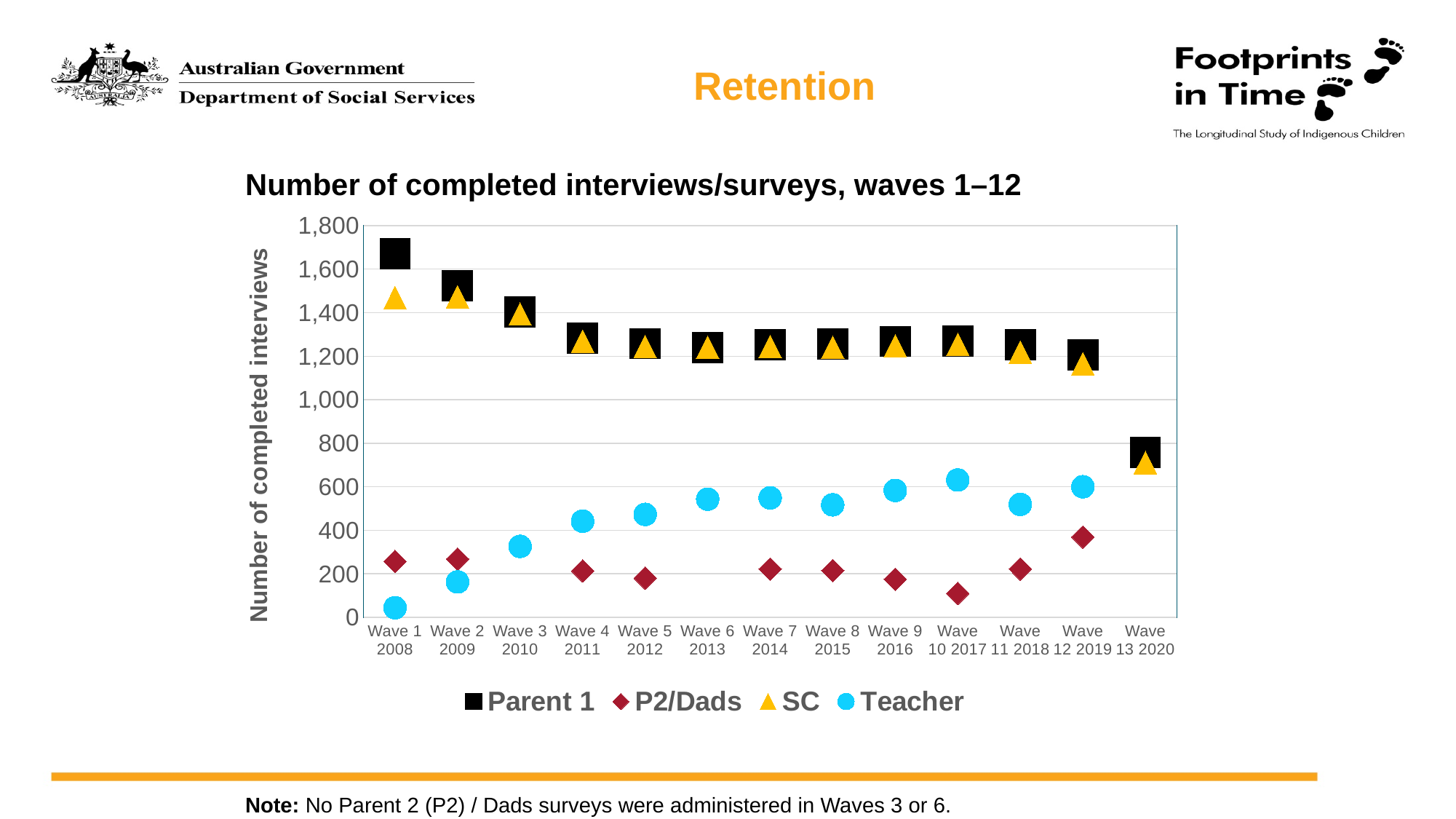
In which wave is the P2/Dads value highest? Wave 12 2019 At Wave 12 2019, which is larger: the Teacher value or the P2/Dads value? Teacher In which wave is the Parent 1 value lowest? Wave 13 2020 In which wave is the Parent 1 value highest? Wave 1 2008 What is the title of the chart? Number of completed interviews/surveys, waves 1–12 Is the Teacher value for Wave 3 2010 greater or less than 400? less How many waves are shown along the x axis? 13 Is the Parent 1 value for Wave 1 2008 greater or less than 1,600? greater What kind of chart is shown on the slide? scatter chart How many series does the legend list? 4 In which wave is the Teacher value lowest? Wave 1 2008 Is the Parent 1 value for Wave 13 2020 greater or less than 1,000? less